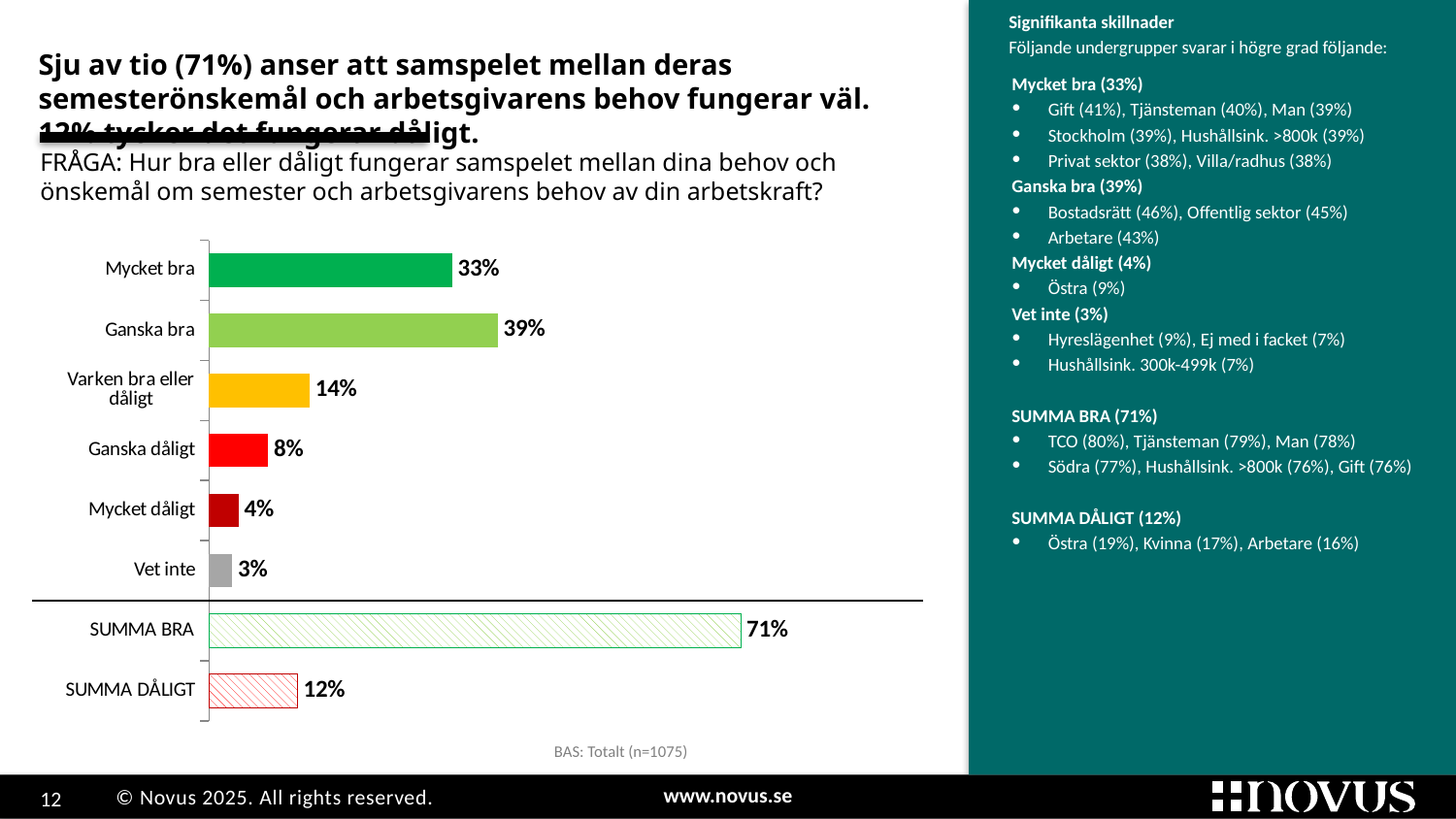
What is the value for SUMMA DÅLIGT? 12% What is the value for Vet inte? 3% What is the value for Ganska bra? 39% What is the value for Mycket bra? 33% Among the six individual response categories (excluding the SUMMA bars), which has the highest value? Ganska bra How many bars are shown in the chart? 8 What is the difference between SUMMA BRA and SUMMA DÅLIGT? 59% What is the value for Varken bra eller dåligt? 14% Which is larger, Ganska dåligt or Mycket dåligt? Ganska dåligt What kind of chart is shown on the slide? Bar chart Which category has the lowest value in the chart? Vet inte What is the difference between Ganska bra and Mycket bra? 6%